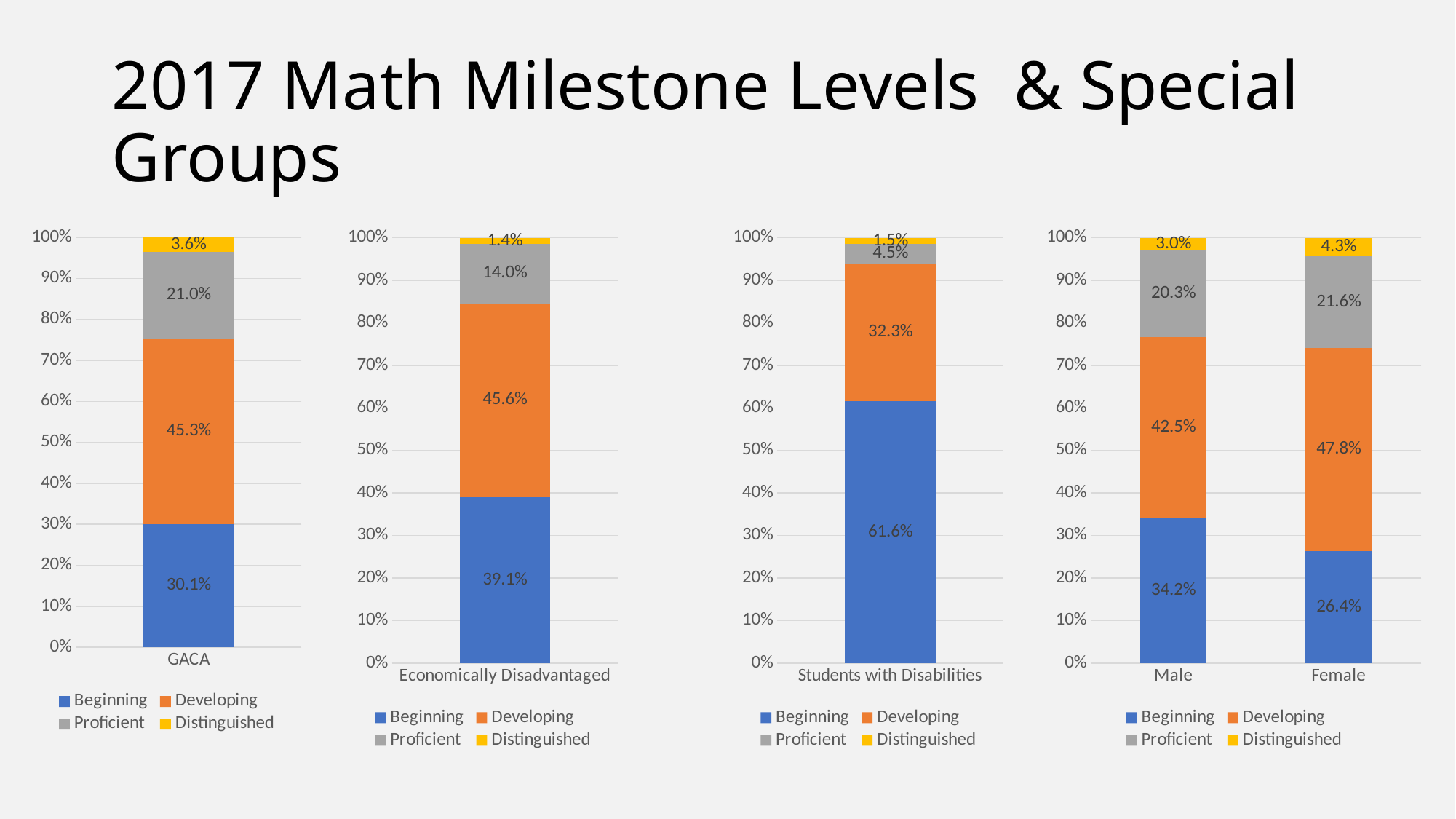
How many series does the legend of the leftmost chart list? 4 How many categories are shown on the x axis of the rightmost chart? 2 In the rightmost chart (Male and Female), what is the Distinguished percentage for Female? 4.3% In the rightmost chart, which group has the larger Beginning percentage, Male or Female? Male What type of chart is the third chart from the left (Students with Disabilities)? Stacked bar chart In the third chart from the left (Students with Disabilities), which level has the largest share? Beginning In the second chart from the left (Economically Disadvantaged), is the Beginning value greater or less than 30%? greater In the third chart from the left (Students with Disabilities), what is the Proficient percentage? 4.5% In the leftmost chart (GACA), what percentage of students are at the Beginning level? 30.1% In the leftmost chart (GACA), which level has the smallest share? Distinguished In the second chart from the left (Economically Disadvantaged), what is the Developing percentage? 45.6% In the rightmost chart, what is the difference between the Developing percentages for Female and Male? 5.3%